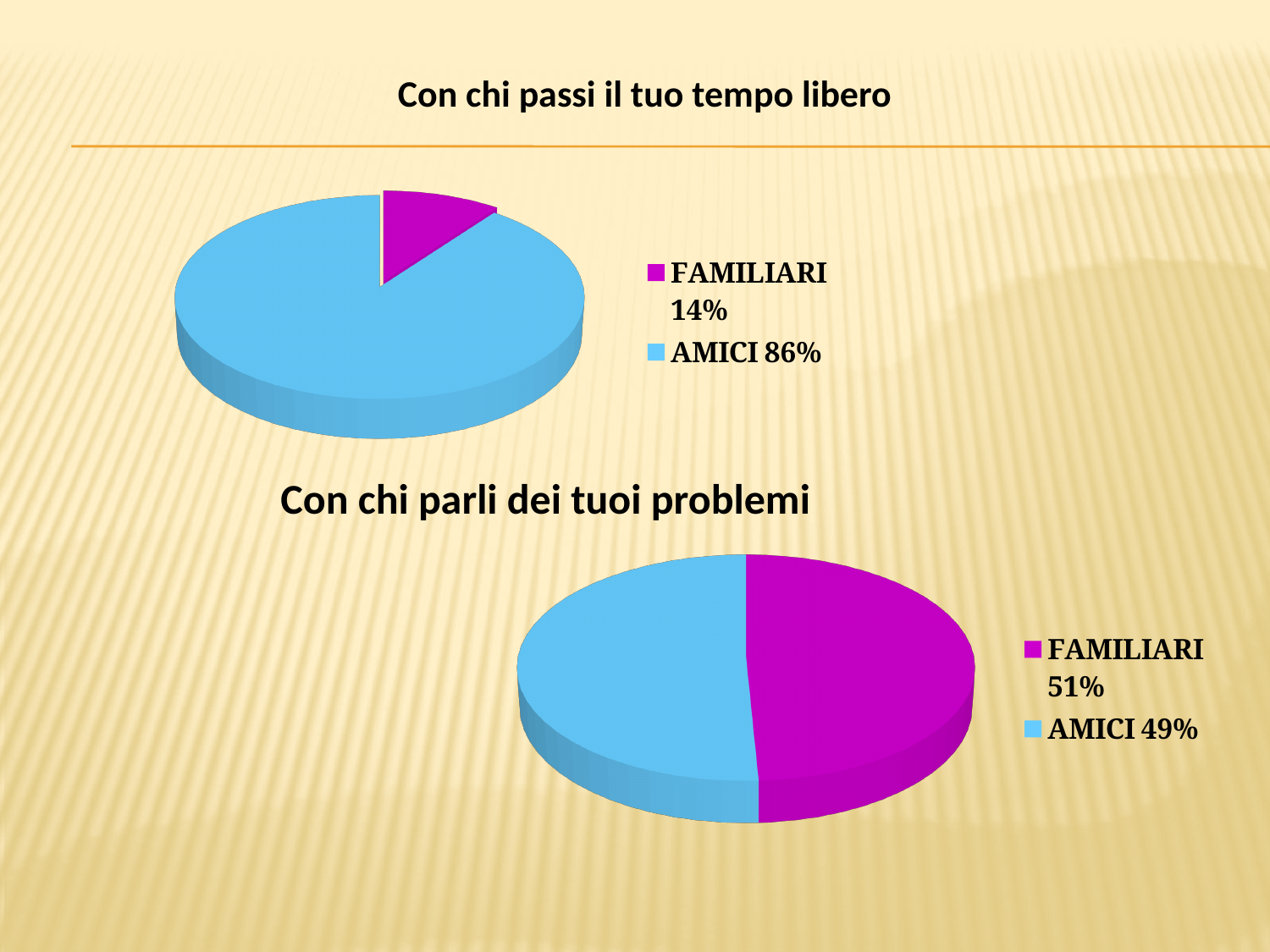
In the chart titled "Con chi passi il tuo tempo libero", what share is shown for AMICI? 86% In the top chart, which category has the largest slice? AMICI In the bottom chart, what colour is the AMICI slice? Light blue In the bottom chart, what is the difference between the FAMILIARI share and the AMICI share? 2% In the top chart, which category has the smallest slice? FAMILIARI In the chart titled "Con chi passi il tuo tempo libero", what share is shown for FAMILIARI? 14% In the top chart, what is the difference between the AMICI share and the FAMILIARI share? 72% What type of chart is used for "Con chi parli dei tuoi problemi"? Pie chart In the chart titled "Con chi parli dei tuoi problemi", what share is shown for AMICI? 49% How many categories does the legend of the top chart list? 2 In the chart titled "Con chi parli dei tuoi problemi", what share is shown for FAMILIARI? 51%